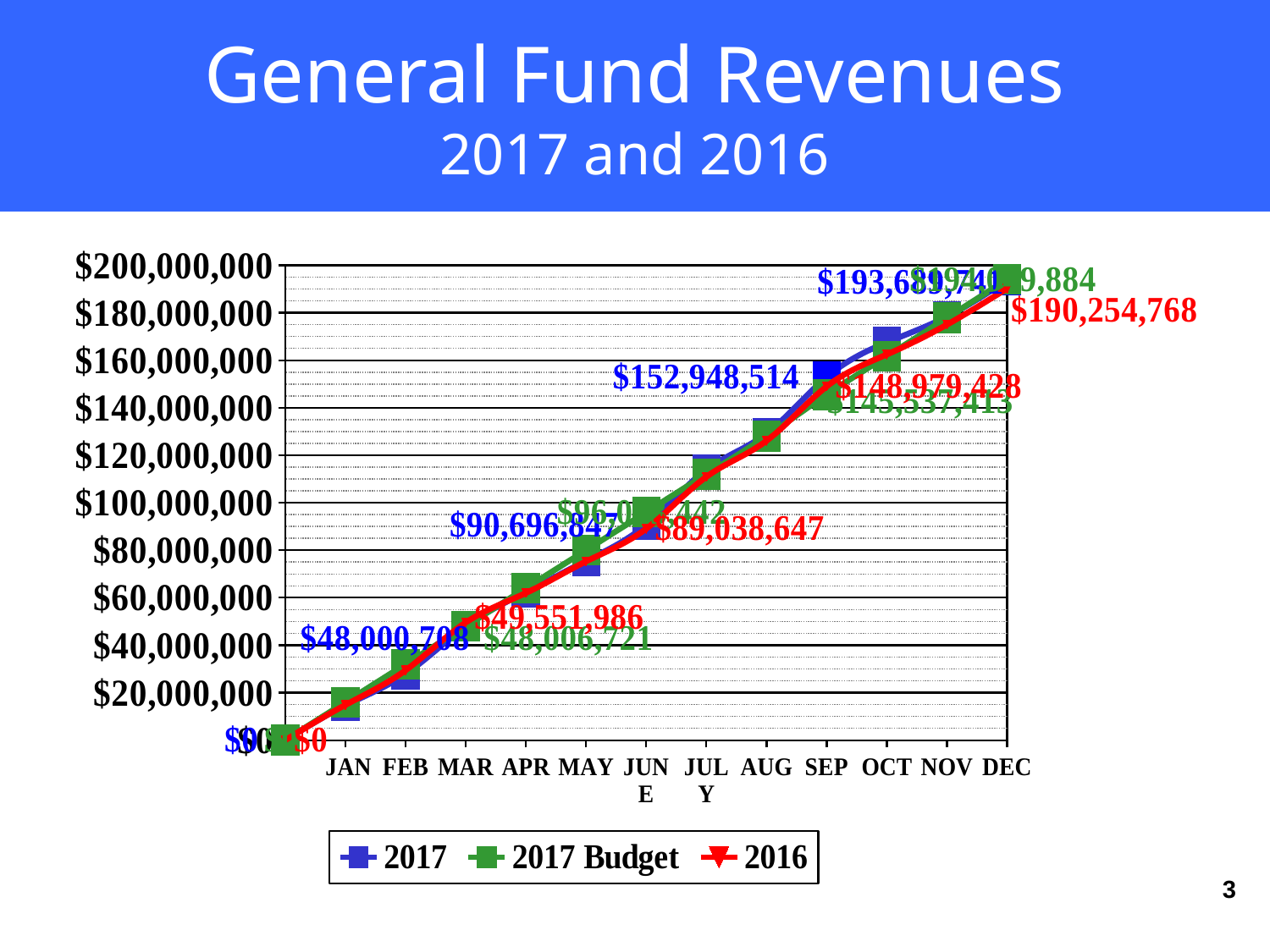
What is the difference between the 2017 value and the 2016 value for SEP? $3,969,086 Do the values for the 2017 series rise or fall from JAN to DEC? rise What is the 2017 Budget value for MAR? $48,006,721 What is the 2016 value for JUNE? $89,038,647 What kind of chart is shown on the slide? line chart Is the 2017 Budget value for AUG greater or less than $120,000,000? greater What is the 2017 value for SEP? $152,948,514 What is the 2016 value for DEC? $190,254,768 What is the 2017 value for JUNE? $90,696,847 What is the 2016 value for MAR? $49,551,986 What is the 2017 value for MAR? $48,000,708 How many series does the legend list? 3